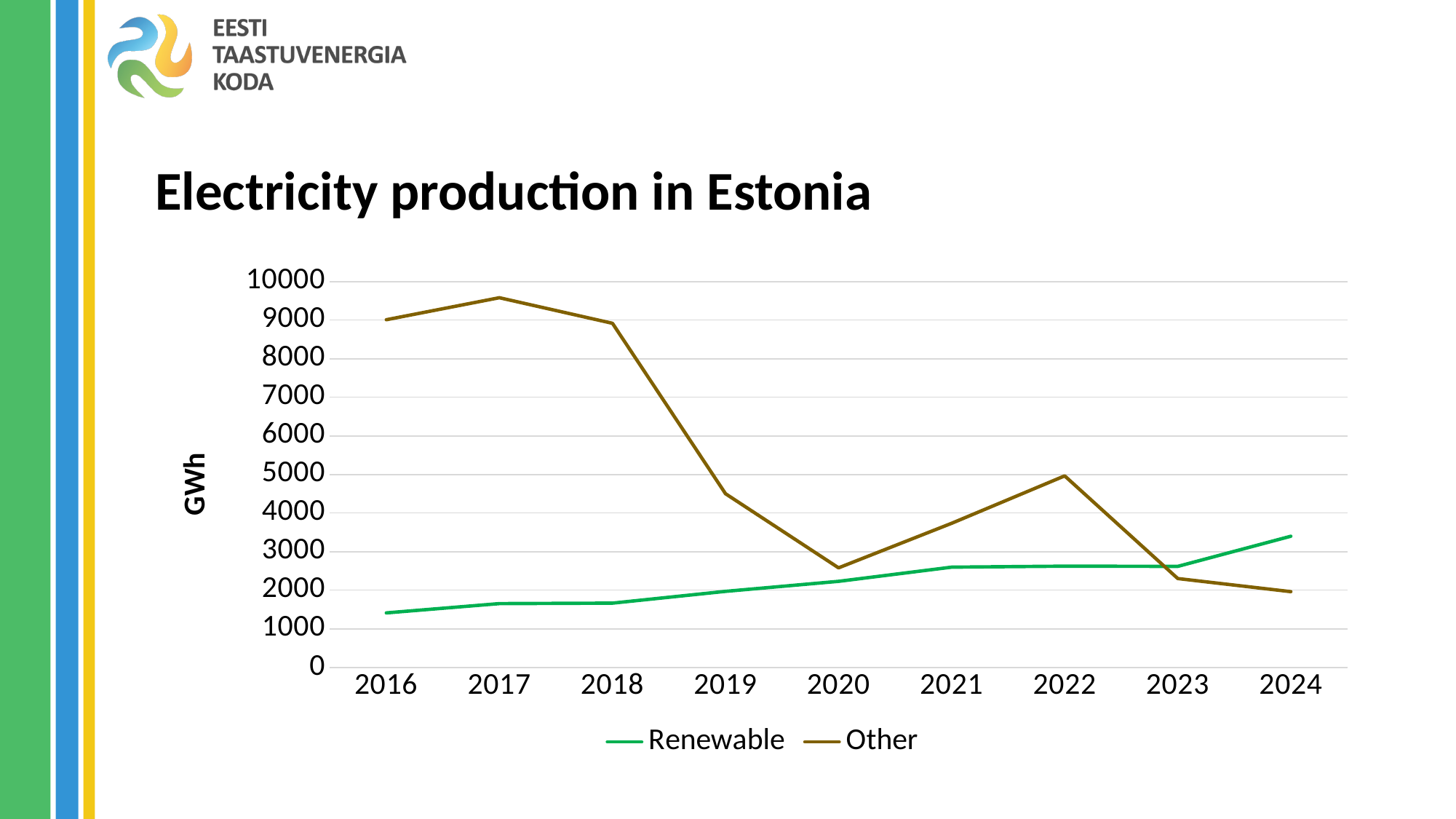
Is the value for Other in 2017 greater or less than 9000? greater How many years are shown on the x axis? 9 Is the value for Renewable in 2024 greater or less than 3000? greater In which year is the Other series at its lowest? 2024 What unit is shown on the y axis label? GWh Is the value for Other in 2020 greater or less than 3000? less In 2016, which series has the larger value, Renewable or Other? Other In which year is the Other series at its highest? 2017 In which year is the Renewable series at its highest? 2024 Does the Renewable series generally rise or fall from 2016 to 2024? rise What kind of chart is shown on the slide? line chart How many series does the legend list? 2